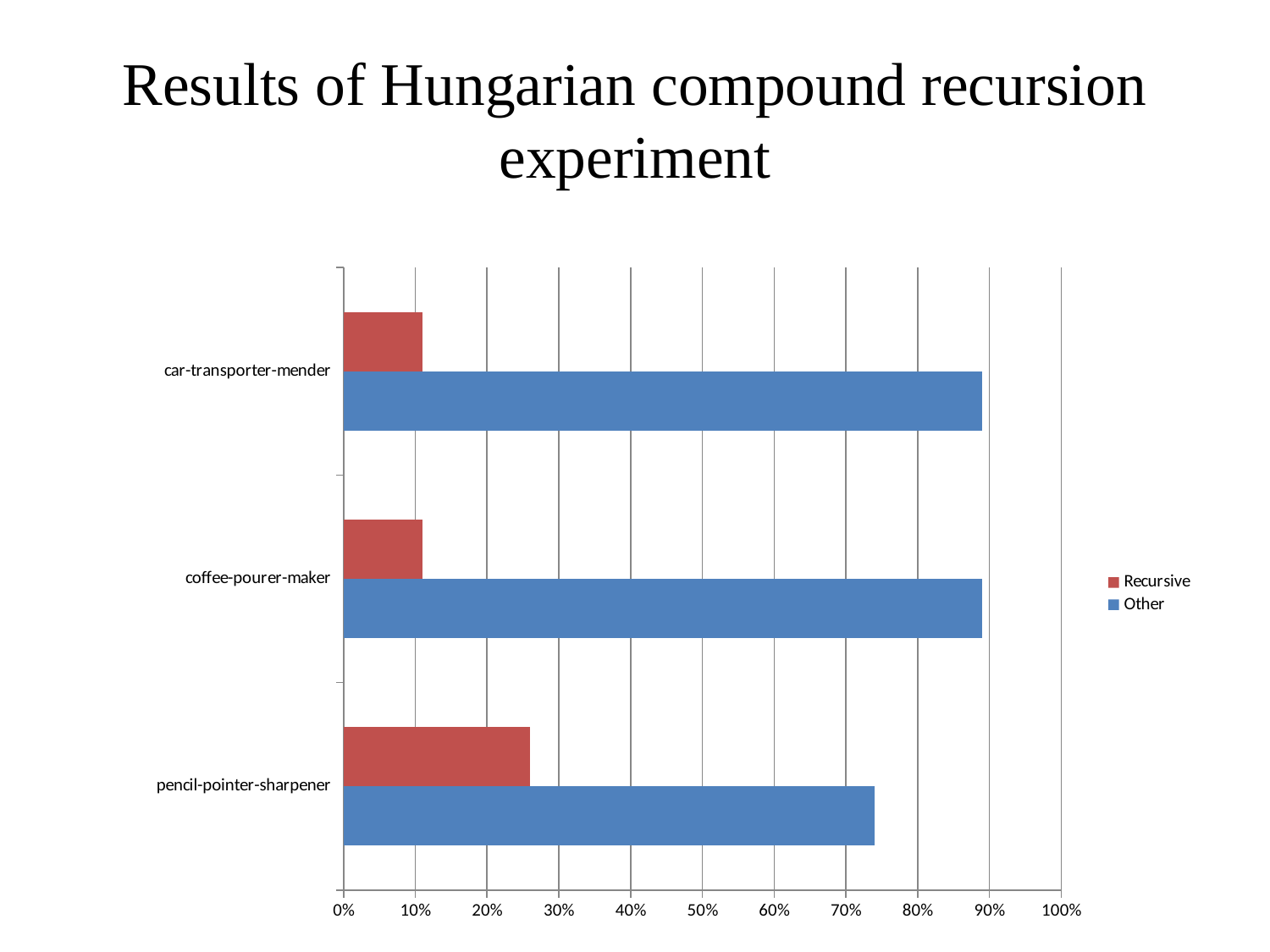
What is the title of the slide? Results of Hungarian compound recursion experiment Which category has the highest Recursive value? pencil-pointer-sharpener Which category has the lowest Other value? pencil-pointer-sharpener Is the Other value for car-transporter-mender greater or less than 80%? greater For pencil-pointer-sharpener, which is larger, the Recursive value or the Other value? Other What kind of chart is shown on the slide? bar chart Is the Other value for pencil-pointer-sharpener greater or less than 80%? less Is the Recursive value for coffee-pourer-maker greater or less than 20%? less How many categories are shown on the chart? 3 Which series is shown in blue? Other How many series does the legend list? 2